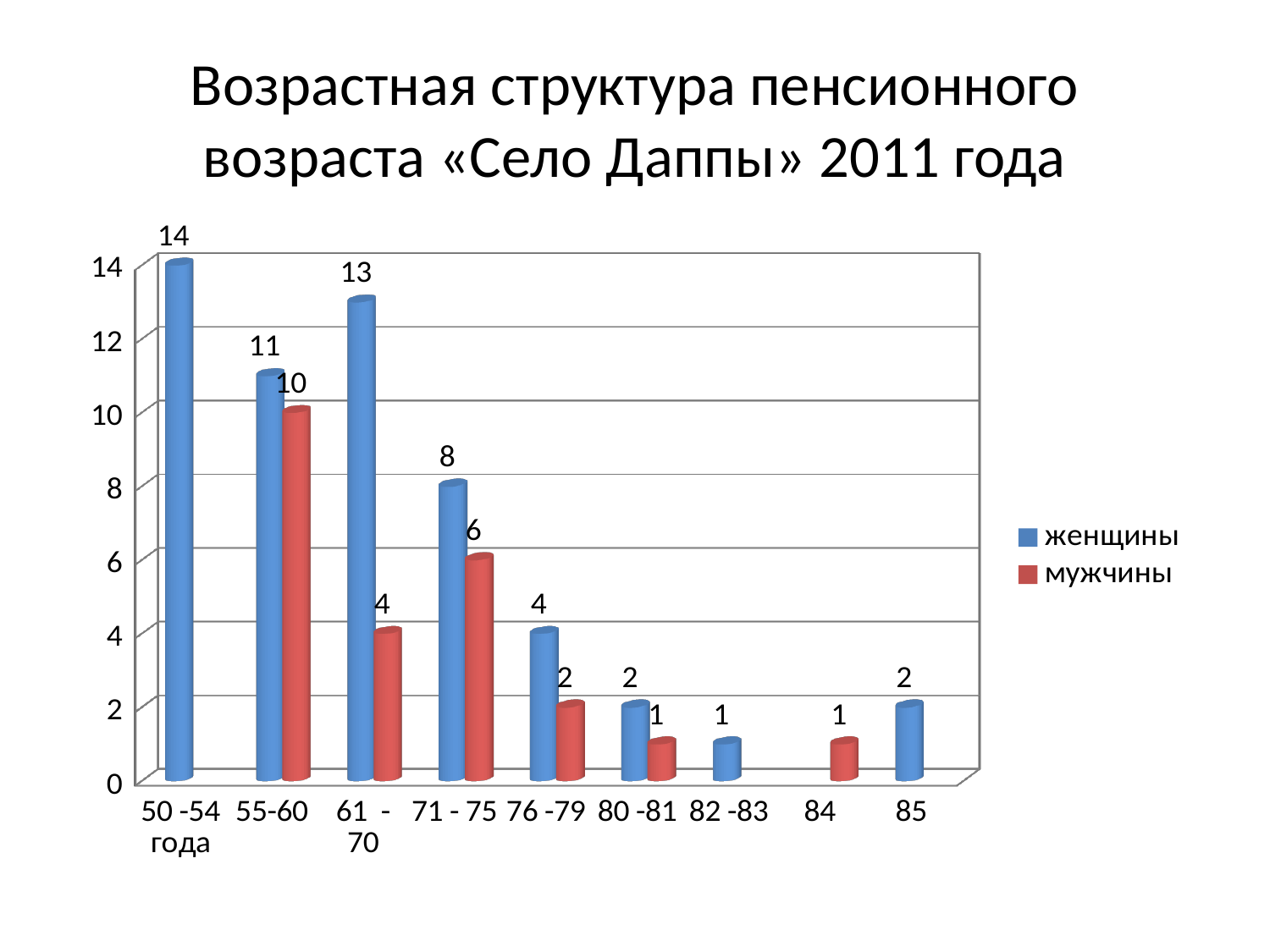
How many age categories are shown on the x axis? 9 How many series does the legend list? 2 Which is larger in the 76 -79 category, женщины or мужчины? женщины What is the value for мужчины in the 55-60 category? 10 What is the value for мужчины in the 71 - 75 category? 6 Which age category has the highest value for мужчины? 55-60 What type of chart is shown on the slide? bar chart What is the value for женщины in the 50 -54 года category? 14 What is the value for женщины in the 61 - 70 category? 13 Which series is shown in red? мужчины What is the difference between женщины and мужчины in the 61 - 70 category? 9 Which age category has the highest value for женщины? 50 -54 года